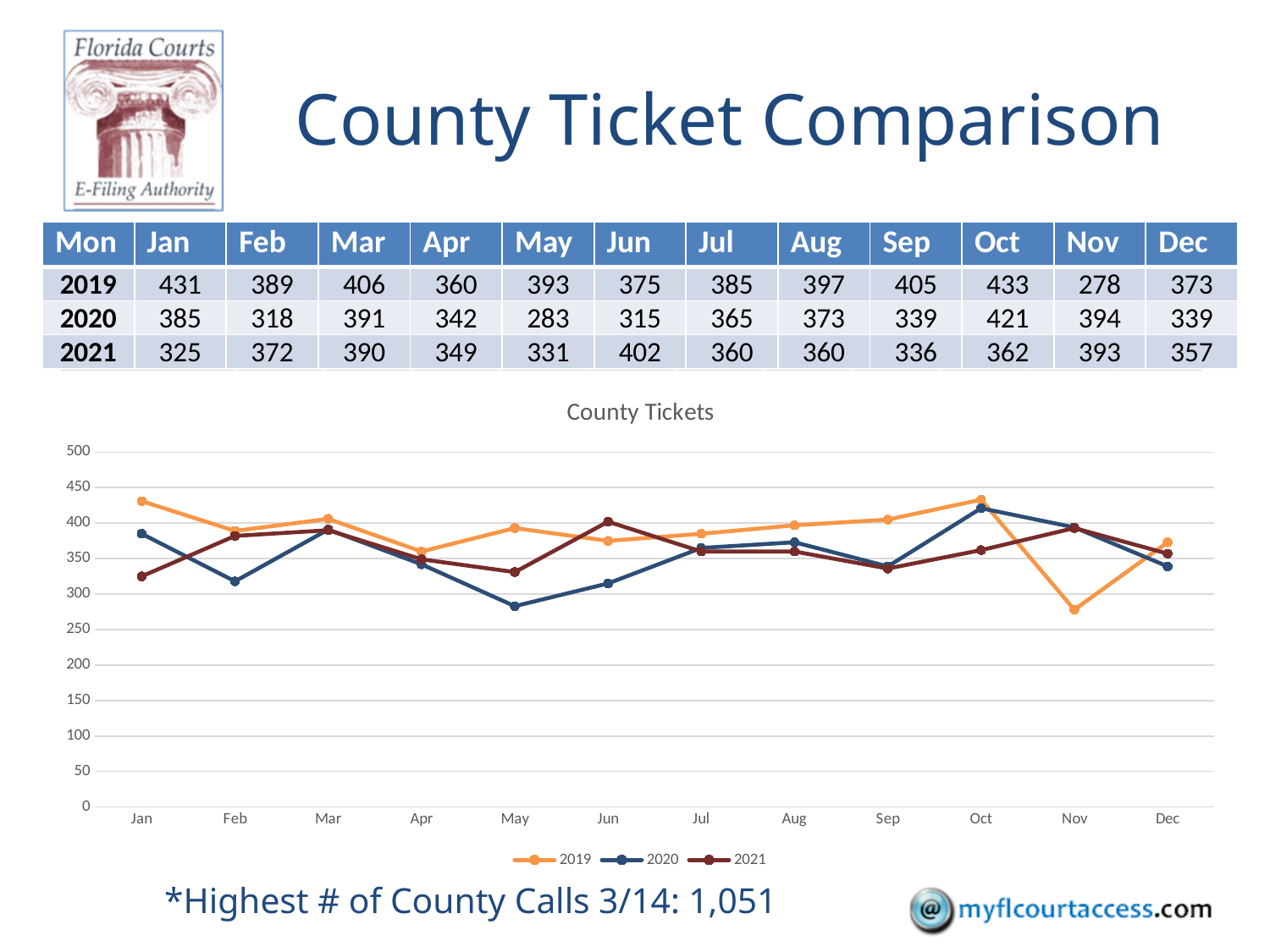
Which month has the lowest 2019 value in the County Tickets chart? Nov Is the 2019 value for Nov in the County Tickets chart greater or less than 300? less Which month has the lowest 2020 value in the County Tickets chart? May What is the 2021 value for Jun in the County Tickets chart? 402 Which series has the larger value for May in the County Tickets chart, 2019 or 2020? 2019 What is the 2020 value for May in the County Tickets chart? 283 How many series does the legend of the County Tickets chart list? 3 How many months are plotted along the x axis of the County Tickets chart? 12 What is the difference between the 2019 and 2020 values for Jan in the County Tickets chart? 46 What is the 2019 value for Oct in the County Tickets chart? 433 What kind of chart is the County Tickets chart? line chart Which month has the highest 2019 value in the County Tickets chart? Oct